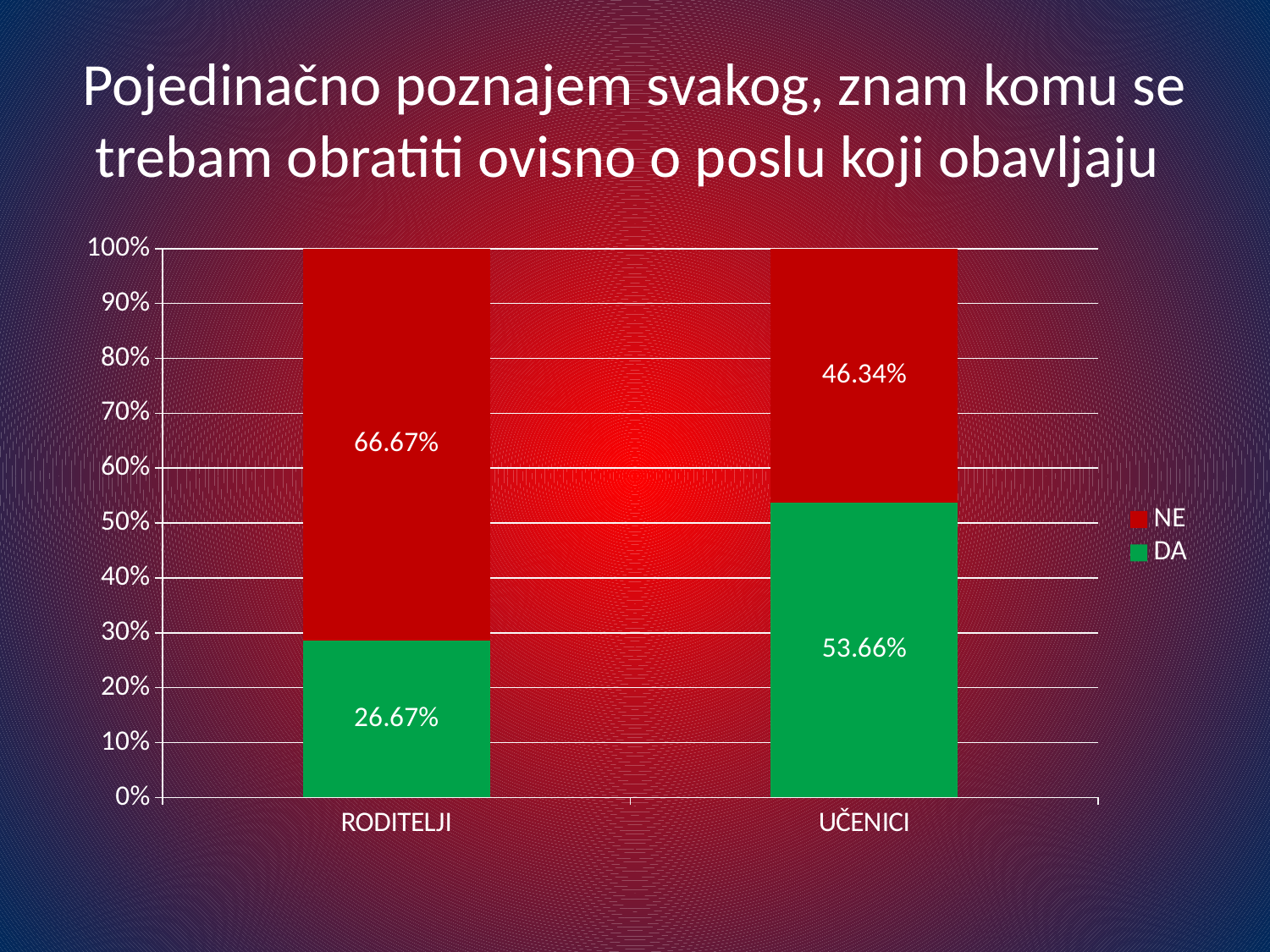
What is the NE value for RODITELJI? 66.67% What is the DA value for RODITELJI? 26.67% What is the difference between the DA values for UČENICI and RODITELJI? 26.99% What is the NE value for UČENICI? 46.34% Which colour represents the NE series in the legend? Red What is the difference between the NE and DA values for RODITELJI? 40.00% Which category has the highest NE value? RODITELJI What is the DA value for UČENICI? 53.66% What kind of chart is shown on the slide? Stacked bar chart Which category has the higher DA value, RODITELJI or UČENICI? UČENICI How many series does the legend list? 2 How many categories are shown on the x axis? 2